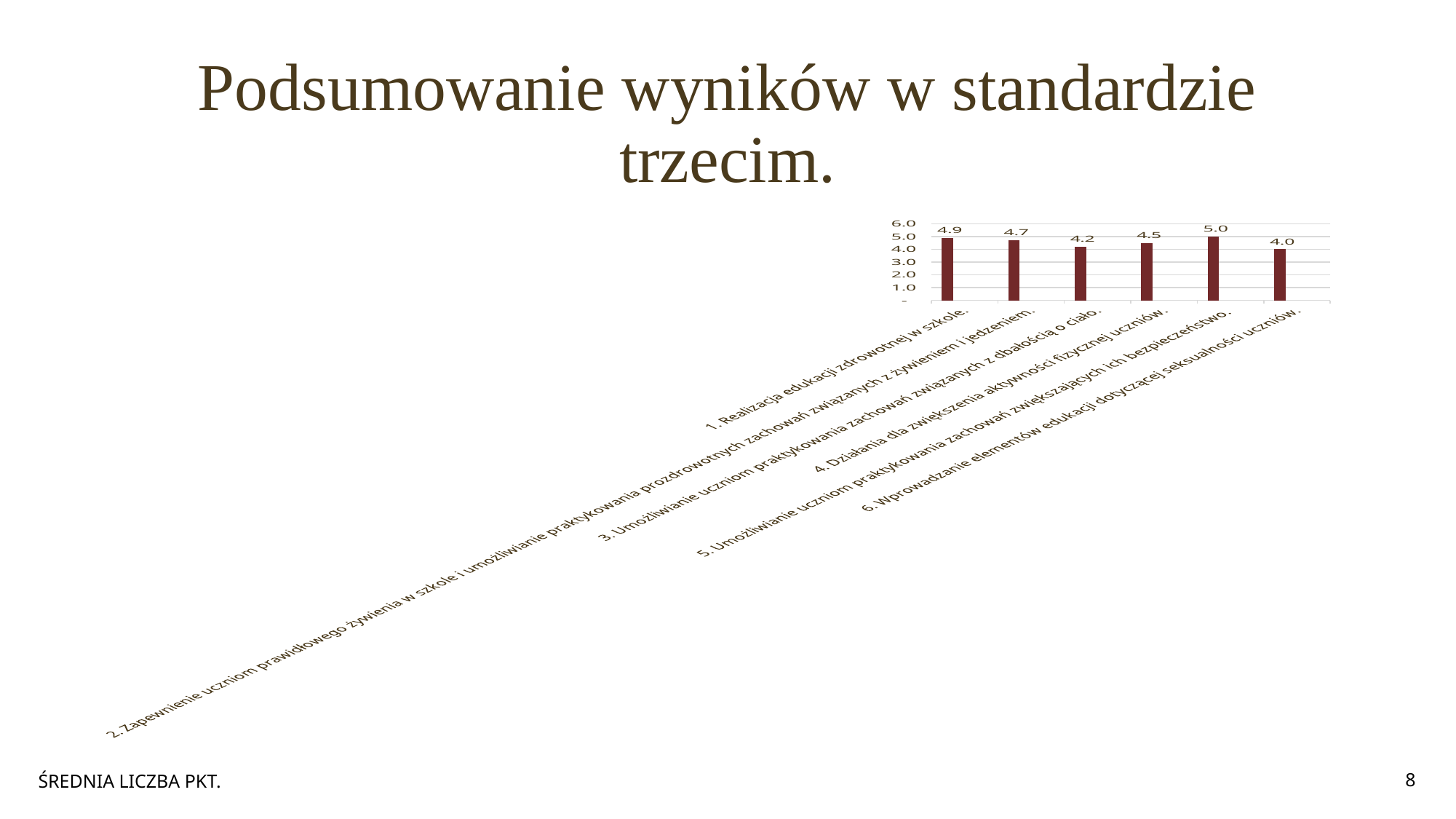
What is the value for category 1, "Realizacja edukacji zdrowotnej w szkole"? 4.9 What is the value for category 6, "Wprowadzanie elementów edukacji dotyczącej seksualności uczniów"? 4.0 What is the difference between the values for category 5 and category 6? 1.0 Which category has the highest value? 5. Umożliwianie uczniom praktykowania zachowań zwiększających ich bezpieczeństwo. What is the value for category 3, "Umożliwianie uczniom praktykowania zachowań związanych z dbałością o ciało"? 4.2 What is the value for category 5, "Umożliwianie uczniom praktykowania zachowań zwiększających ich bezpieczeństwo"? 5.0 How many categories are shown in the chart? 6 Which category has the lowest value? 6. Wprowadzanie elementów edukacji dotyczącej seksualności uczniów. What is the maximum value shown on the vertical axis of the chart? 6.0 What kind of chart is shown on the slide? Bar chart Which has a larger value, category 2 (Zapewnienie uczniom prawidłowego żywienia...) or category 4 (Działania dla zwiększenia aktywności fizycznej uczniów)? Category 2 What is the difference between the values for category 1 and category 3? 0.7